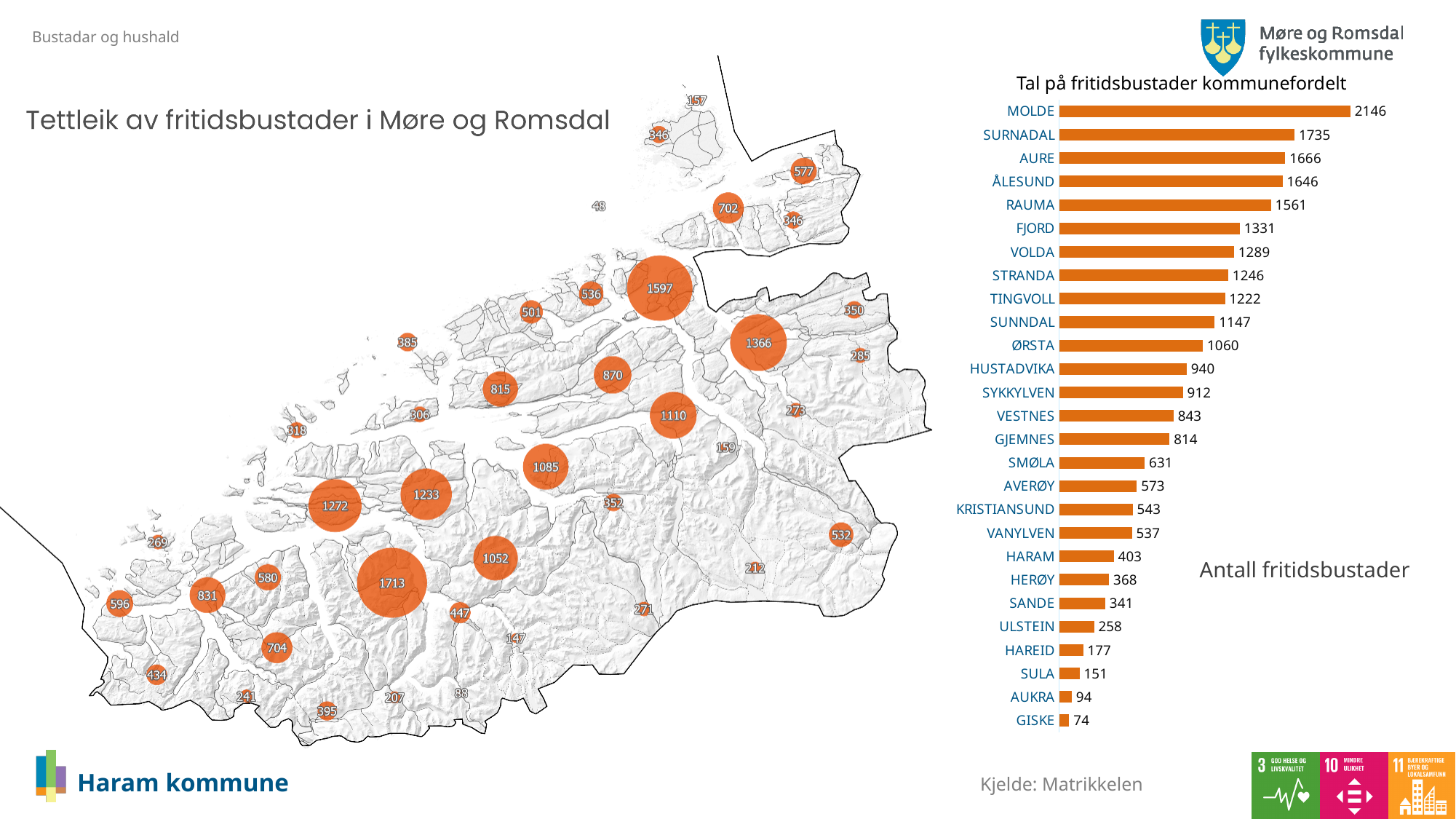
What kind of chart is 'Tal på fritidsbustader kommunefordelt'? Bar chart In the bar chart 'Tal på fritidsbustader kommunefordelt', which municipality has the lowest value? GISKE In the bar chart 'Tal på fritidsbustader kommunefordelt', which has a larger value, VOLDA or ØRSTA? VOLDA In the bar chart 'Tal på fritidsbustader kommunefordelt', what is the value for STRANDA? 1246 In the bar chart 'Tal på fritidsbustader kommunefordelt', which has a larger value, SULA or ULSTEIN? ULSTEIN How many municipalities are listed in the bar chart 'Tal på fritidsbustader kommunefordelt'? 27 In the bar chart 'Tal på fritidsbustader kommunefordelt', what is the difference between the values for MOLDE and SURNADAL? 411 In the bar chart 'Tal på fritidsbustader kommunefordelt', what is the value for HARAM? 403 In the bar chart 'Tal på fritidsbustader kommunefordelt', what is the difference between the values for HARAM and HERØY? 35 What is the title of the bar chart on the right side of the slide? Tal på fritidsbustader kommunefordelt In the bar chart 'Tal på fritidsbustader kommunefordelt', what is the value for MOLDE? 2146 In the bar chart 'Tal på fritidsbustader kommunefordelt', which municipality has the highest value? MOLDE